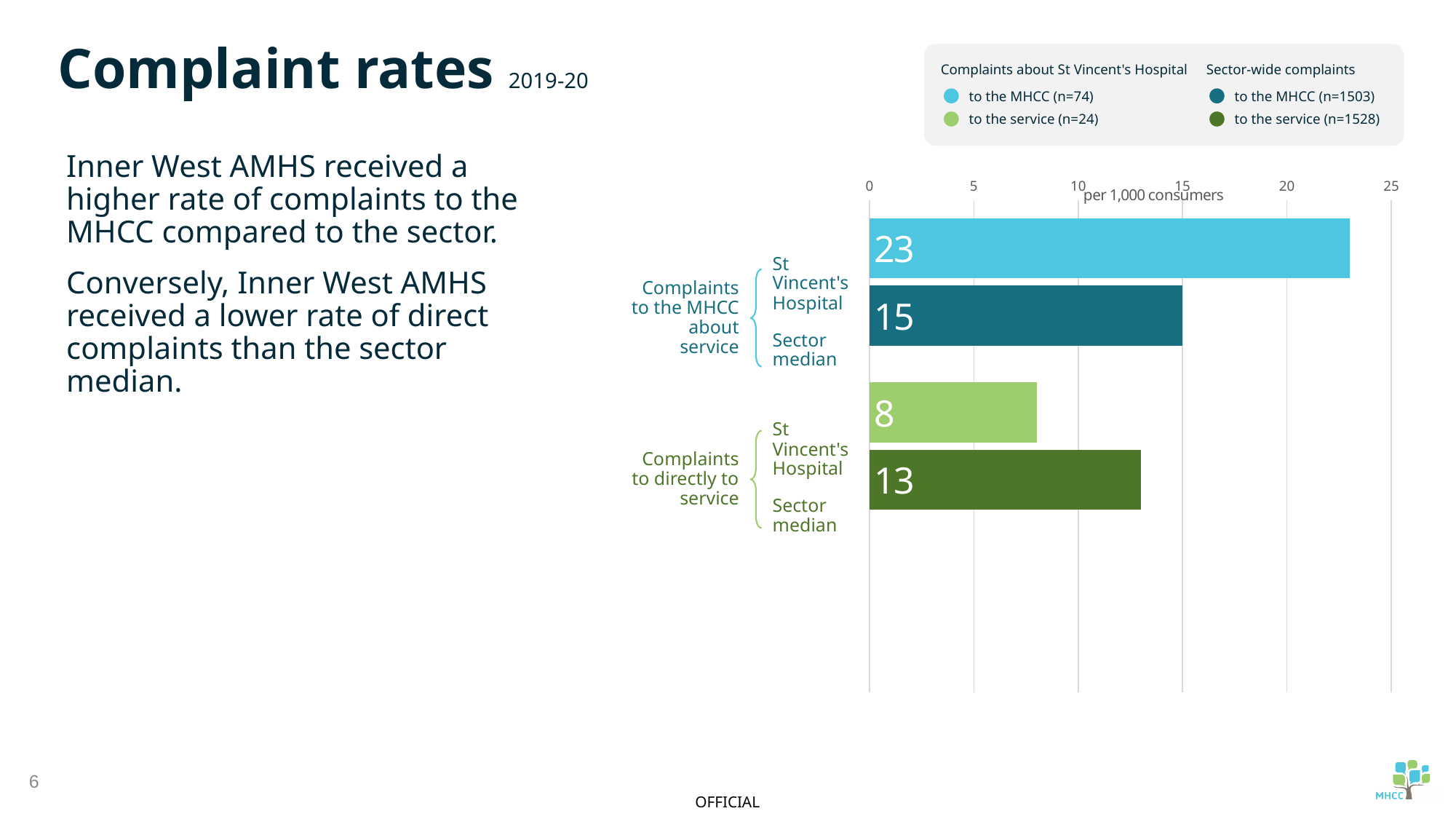
According to the legend, how many complaints about St Vincent's Hospital were made to the MHCC (n)? 74 What is the difference between St Vincent's Hospital and the sector median for complaints to the MHCC? 8 Which bar has the highest value on the chart? St Vincent's Hospital, complaints to the MHCC (23) What is the difference between the sector median and St Vincent's Hospital for complaints directly to the service? 5 What is the rate of complaints to the MHCC about St Vincent's Hospital per 1,000 consumers? 23 What is the sector median rate of complaints made directly to the service per 1,000 consumers? 13 Which bar has the lowest value on the chart? St Vincent's Hospital, complaints directly to service (8) For complaints directly to the service, which is larger: St Vincent's Hospital or the sector median? Sector median What type of chart is shown on the slide? Bar chart How many bars are plotted on the chart? 4 What is the rate of complaints made directly to the service for St Vincent's Hospital per 1,000 consumers? 8 What is the sector median rate of complaints to the MHCC per 1,000 consumers? 15